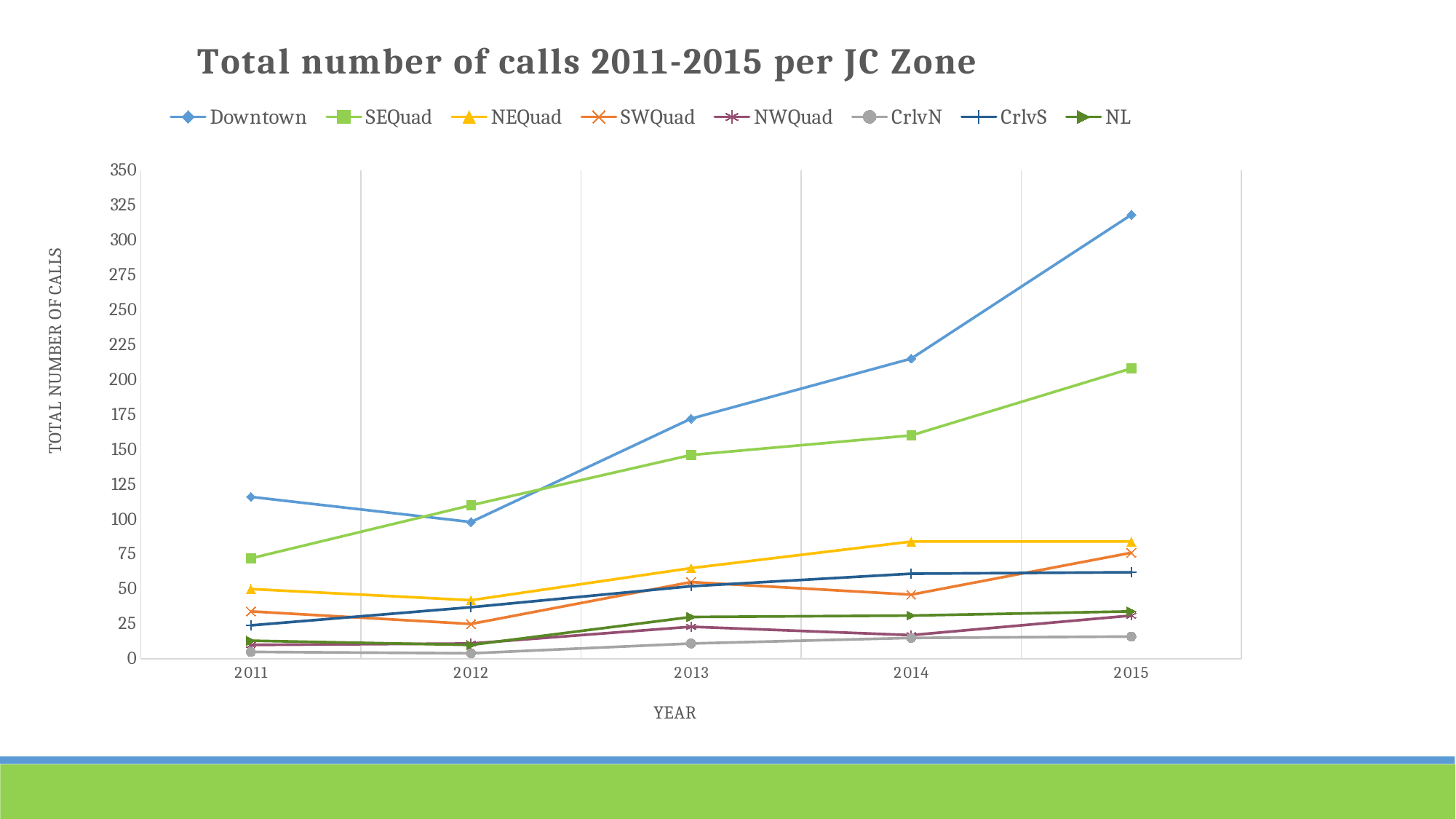
Do the values for SEQuad rise or fall from 2011 to 2015? rise What is the title of the y axis? TOTAL NUMBER OF CALLS Is the value for Downtown in 2015 greater or less than 300? greater How many series does the legend list? 8 In 2012, which has more calls: Downtown or SEQuad? SEQuad Which zone has the highest number of calls in 2015? Downtown What kind of chart is shown on the slide? line chart How many years are plotted along the x axis? 5 In 2011, which has more calls: Downtown or SEQuad? Downtown Is the value for Downtown in 2012 greater or less than 125? less Which zone has the lowest number of calls in 2011? CrlvN Is the value for SEQuad in 2015 greater or less than 175? greater